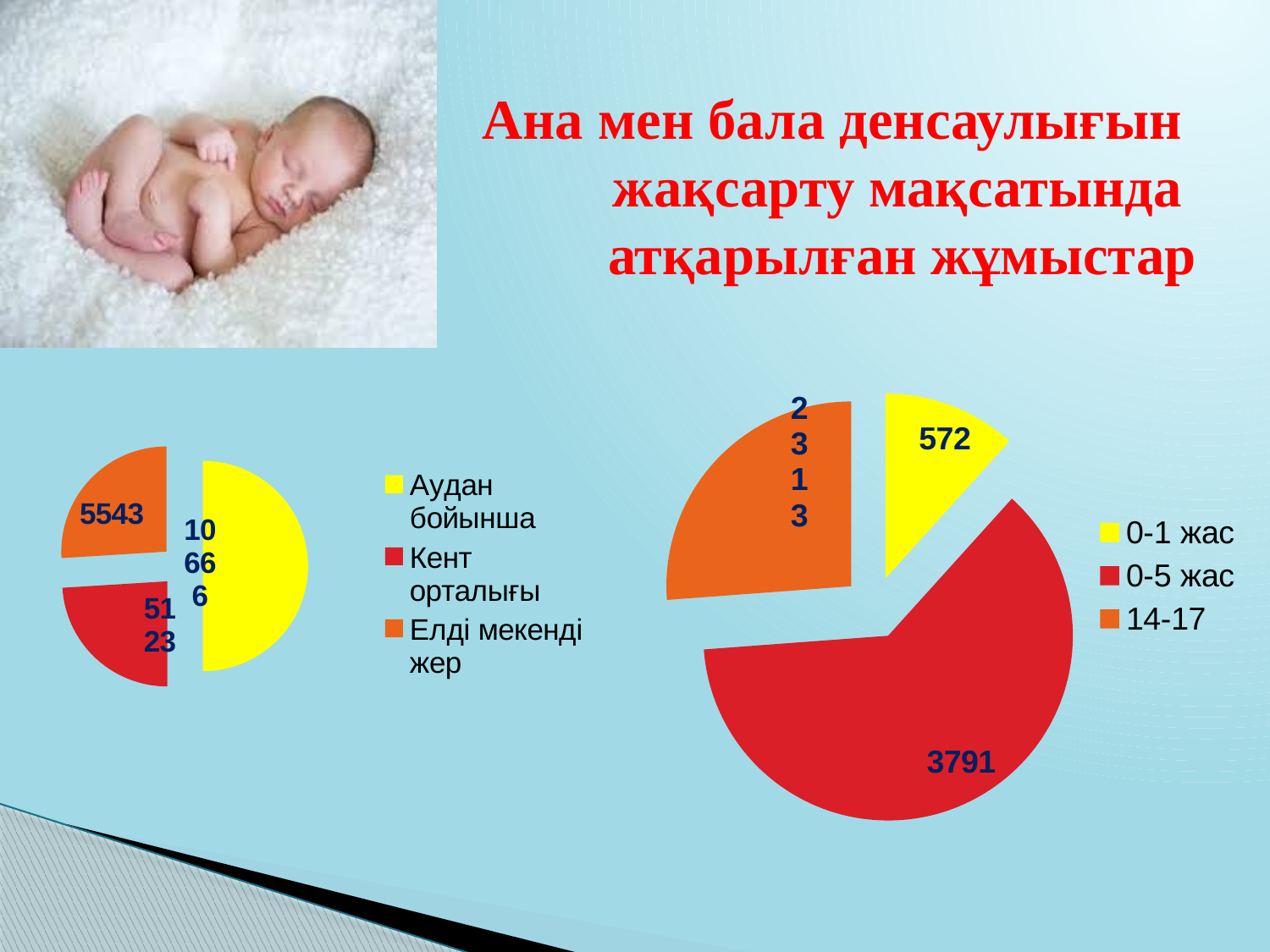
In the right pie chart, what is the value for 0-5 жас? 3791 In the left pie chart, what is the difference between Елді мекенді жер and Кент орталығы? 420 What kind of chart is the chart on the left of the slide? pie chart In the left pie chart, what is the value for Елді мекенді жер? 5543 In the left pie chart, what is the value for Кент орталығы? 5123 In the right pie chart, what is the difference between 0-5 жас and 14-17? 1478 How many categories does the legend of the right pie chart list? 3 In the right pie chart, what is the value for 0-1 жас? 572 In the left pie chart, what share of the total does Аудан бойынша represent? 50% In the right pie chart, which category has the smallest value? 0-1 жас In the left pie chart, which category has the largest value? Аудан бойынша In the left pie chart, what is the value for Аудан бойынша? 10666